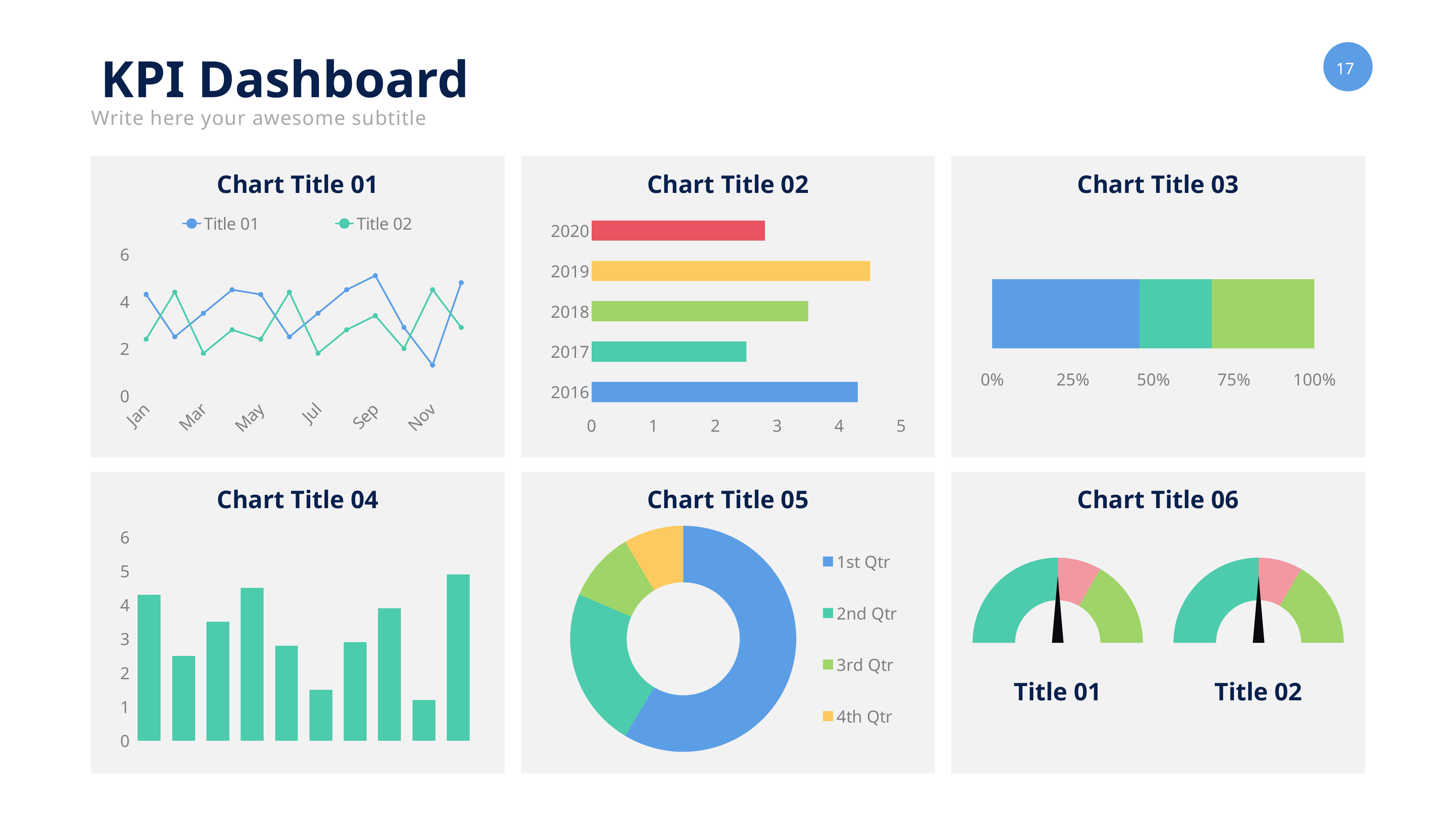
In Chart Title 02, which has the larger value, 2016 or 2018? 2016 What kind of chart is Chart Title 01? line chart How many bars are plotted in Chart Title 04? 10 In Chart Title 02, which year has the highest value? 2019 In Chart Title 05, which quarter has the smallest slice? 4th Qtr In Chart Title 05, which quarter has the largest slice? 1st Qtr In Chart Title 02, is the value for 2019 greater or less than 4? greater How many series does the legend of Chart Title 01 list? 2 In Chart Title 02, is the value for 2017 greater or less than 3? less In Chart Title 02, which year has the lowest value? 2017 How many years are shown in Chart Title 02? 5 What kind of chart is Chart Title 02? bar chart